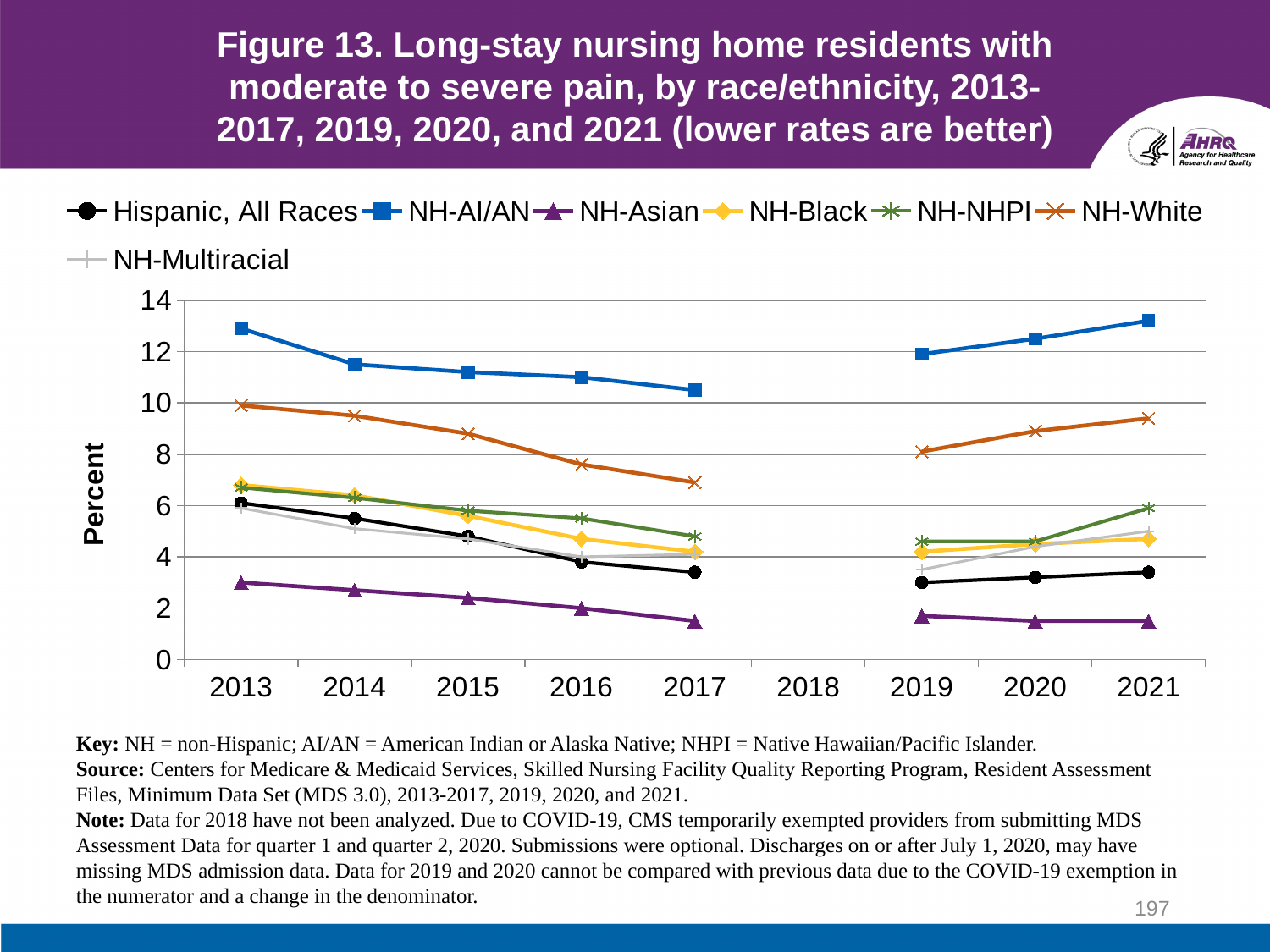
Which race/ethnicity group has the highest value in 2021? NH-AI/AN Is the value for NH-Asian in 2017 greater or less than 2? less Which is larger in 2013, the value for NH-White or the value for NH-Black? NH-White What kind of chart is shown on the slide? line chart Which race/ethnicity group has the lowest value in 2021? NH-Asian Does the NH-AI/AN line rise or fall from 2013 to 2017? fall What is the label on the vertical axis? Percent Is the value for NH-White in 2016 greater or less than 8? less Does the NH-White line rise or fall from 2019 to 2021? rise How many series does the legend list? 7 Is the value for Hispanic, All Races in 2019 greater or less than 4? less